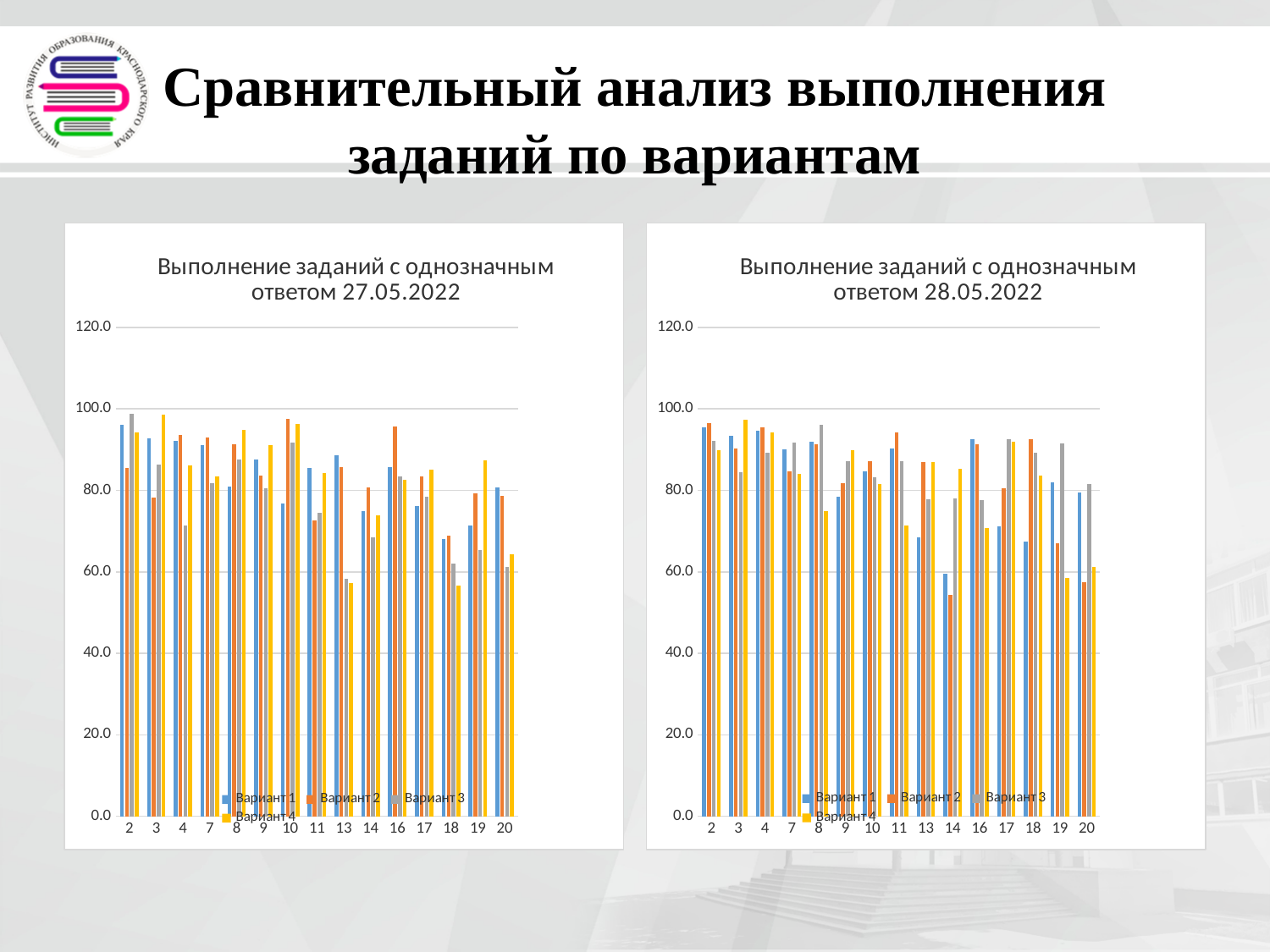
In the left chart (27.05.2022), at category 13, which is larger: Вариант 1 or Вариант 4? Вариант 1 What is the title of the right chart? Выполнение заданий с однозначным ответом 28.05.2022 In the right chart (28.05.2022), is the value for Вариант 1 at category 2 greater or less than 80? greater In the left chart (27.05.2022), is the value for Вариант 4 at category 18 greater or less than 60? less In the right chart (28.05.2022), is the value for Вариант 4 at category 8 greater or less than 80? less What kind of chart is the left chart, titled "Выполнение заданий с однозначным ответом 27.05.2022"? bar chart What is the highest value shown on the vertical axis of the left chart (27.05.2022)? 120.0 How many series does the legend of the right chart (28.05.2022) list? 4 In the right chart (28.05.2022), at category 14, which is larger: Вариант 2 or Вариант 4? Вариант 4 How many categories are shown on the x axis of the left chart (27.05.2022)? 15